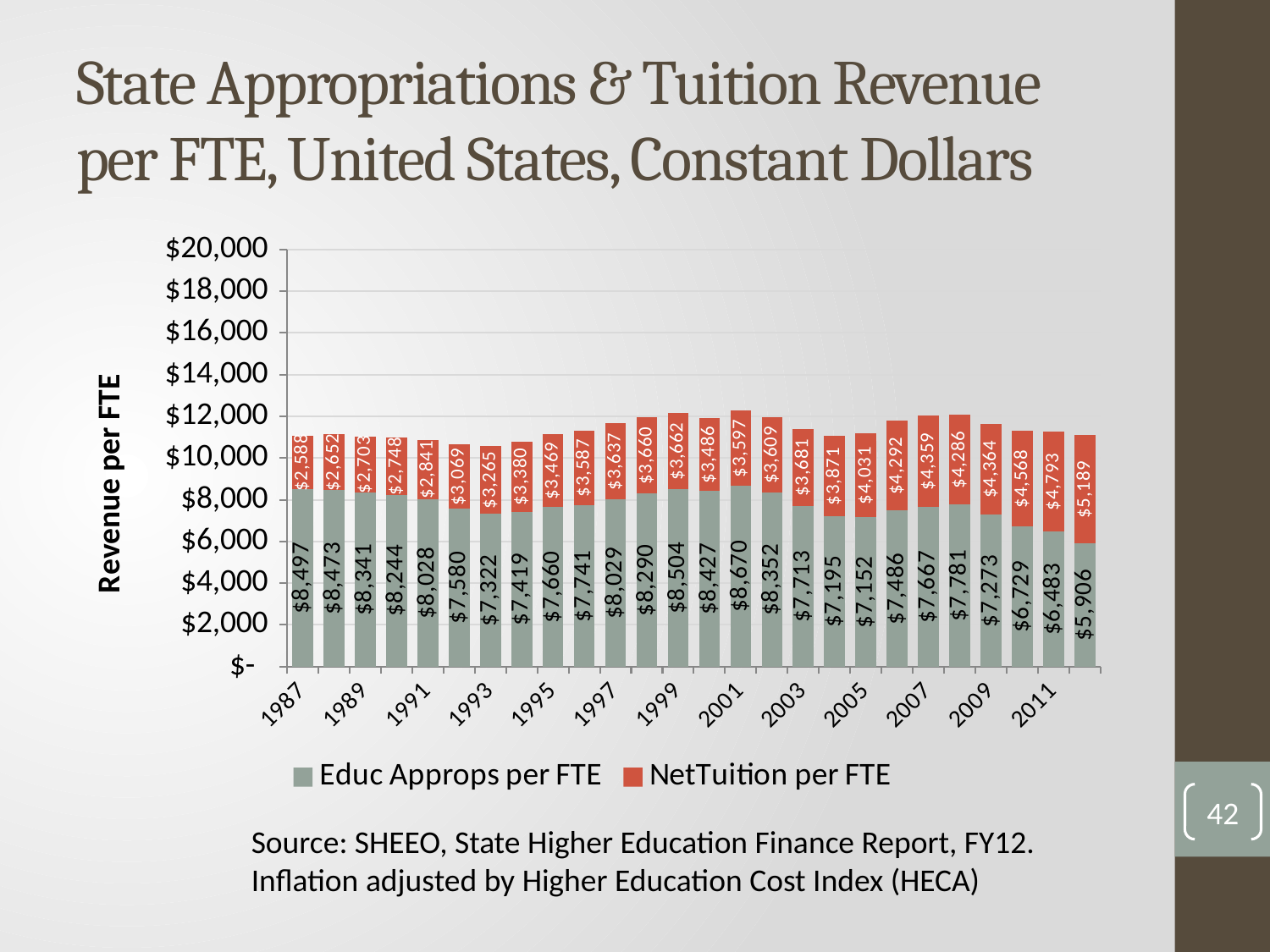
Does NetTuition per FTE generally rise or fall from 1987 to the end of the chart? Rise What is the Educ Approps per FTE value for 1987? $8,497 What is the lowest Educ Approps per FTE value shown on the chart? $5,906 What colour represents NetTuition per FTE in the chart? Red Is the total height of the 2001 stacked bar greater or less than $12,000? greater In 2005, which is larger: Educ Approps per FTE or NetTuition per FTE? Educ Approps per FTE What is the difference between Educ Approps per FTE in 1987 and in 2011? $2,014 What is the NetTuition per FTE value for 2011? $4,793 What kind of chart is shown on the slide? Stacked bar chart How many series does the legend list? 2 In which year is Educ Approps per FTE highest? 2001 What is the total of the stacked bar for 1987 (Educ Approps plus NetTuition per FTE)? $11,085